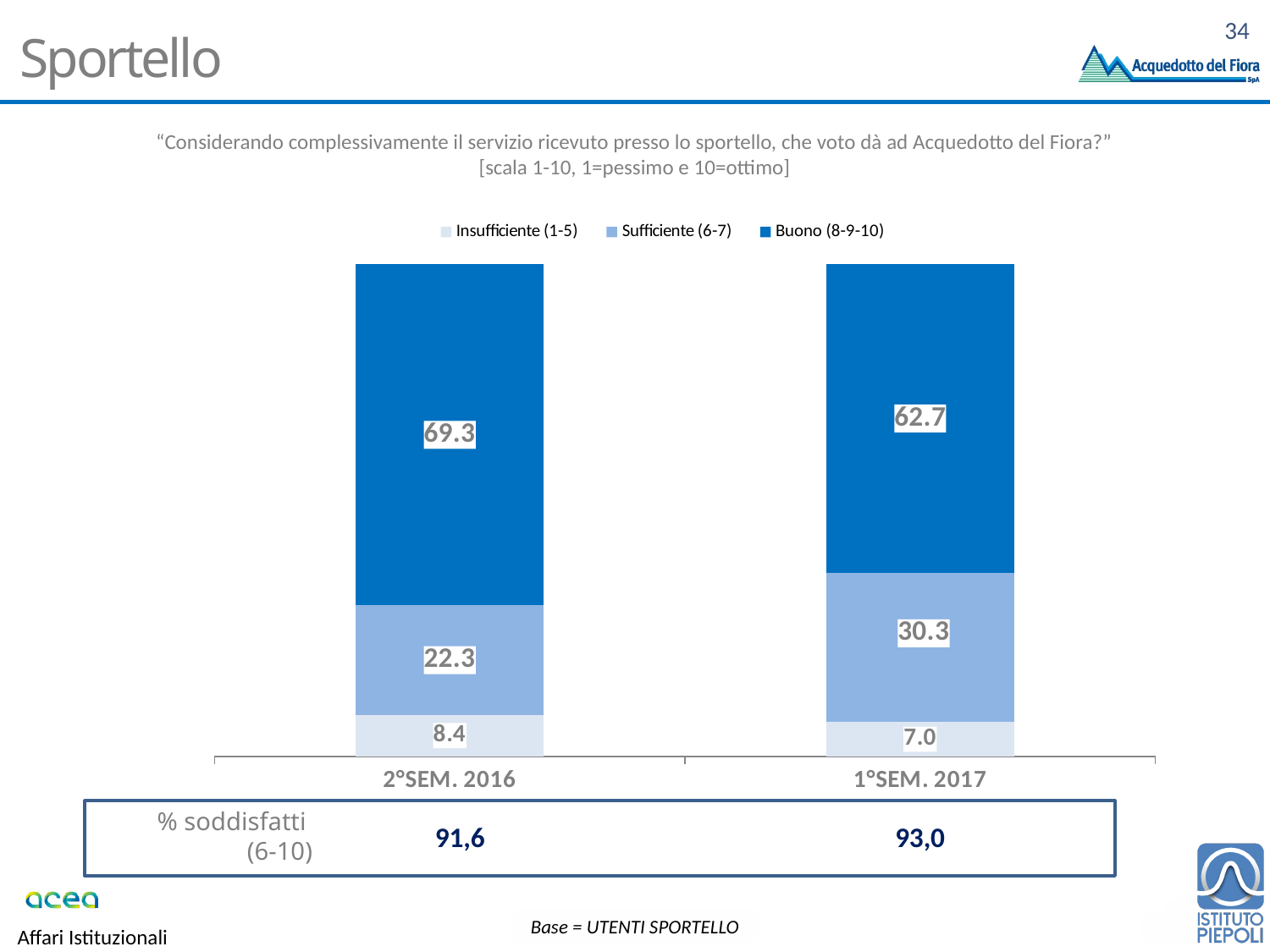
Is the Sufficiente (6-7) value larger in 2°SEM. 2016 or in 1°SEM. 2017? 1°SEM. 2017 Which period has the lower value for Insufficiente (1-5)? 1°SEM. 2017 What is the value for Buono (8-9-10) in 2°SEM. 2016? 69.3 What is the difference between the Buono (8-9-10) values for 2°SEM. 2016 and 1°SEM. 2017? 6.6 What is the value for Sufficiente (6-7) in 2°SEM. 2016? 22.3 Which period has the higher value for Buono (8-9-10)? 2°SEM. 2016 What kind of chart is shown on the slide? Stacked bar chart What is the total of the stacked bar for 1°SEM. 2017? 100.0 How many periods are shown on the x axis of the chart? 2 What is the value for Sufficiente (6-7) in 1°SEM. 2017? 30.3 How many series does the legend list? 3 What is the value for Insufficiente (1-5) in 1°SEM. 2017? 7.0